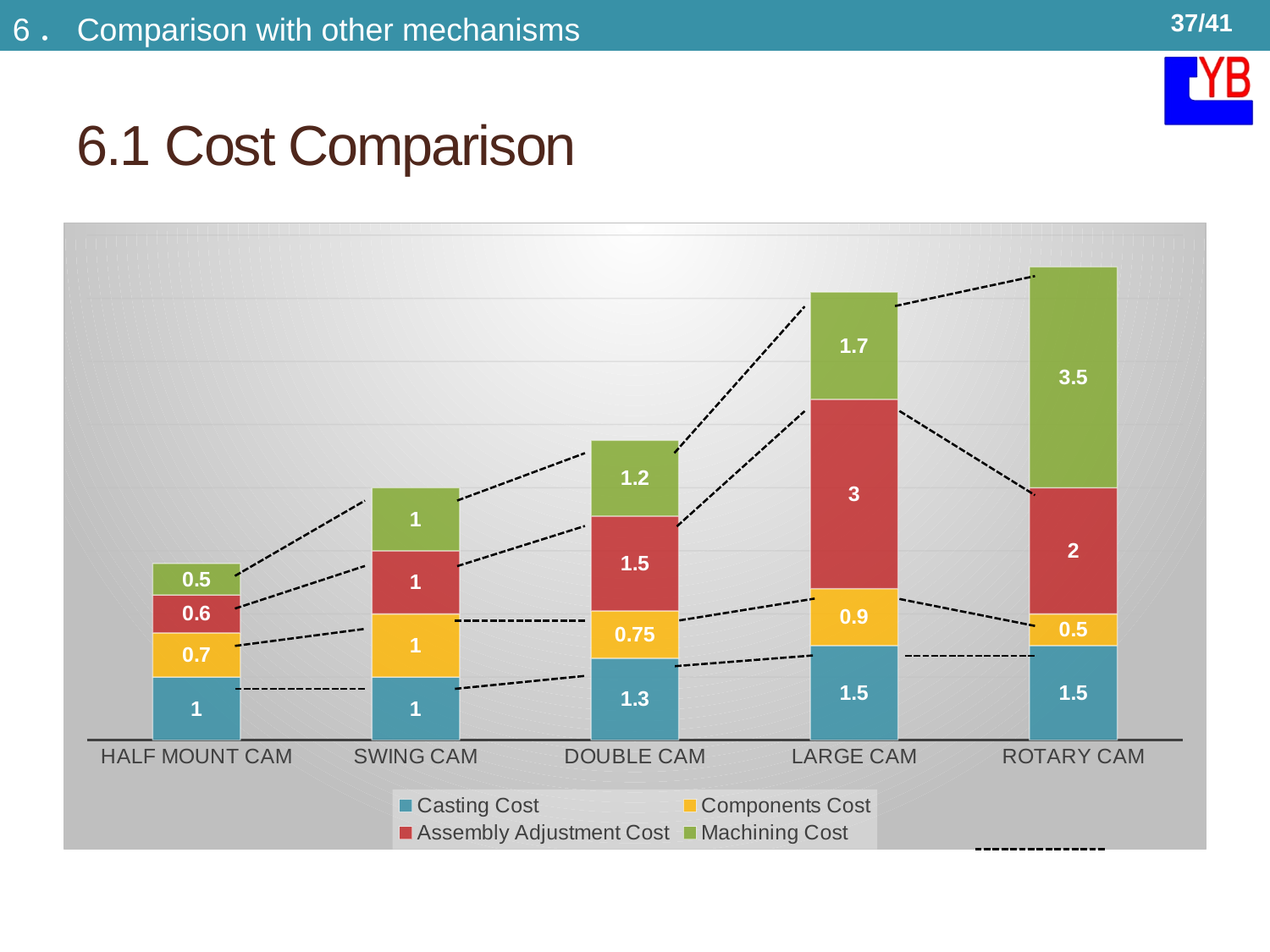
Which category has the highest Machining Cost? ROTARY CAM What kind of chart is shown on the slide? Stacked bar chart What is the difference between the Assembly Adjustment Cost for LARGE CAM and for ROTARY CAM? 1 What is the Machining Cost for ROTARY CAM? 3.5 How many series does the legend list? 4 Which category has the lowest Components Cost? ROTARY CAM What is the total of the stacked bar for SWING CAM? 4 How many categories are shown on the x axis? 5 What is the Components Cost for DOUBLE CAM? 0.75 What is the Assembly Adjustment Cost for LARGE CAM? 3 What is the Casting Cost for HALF MOUNT CAM? 1 Which is larger, the Machining Cost for LARGE CAM or for DOUBLE CAM? LARGE CAM